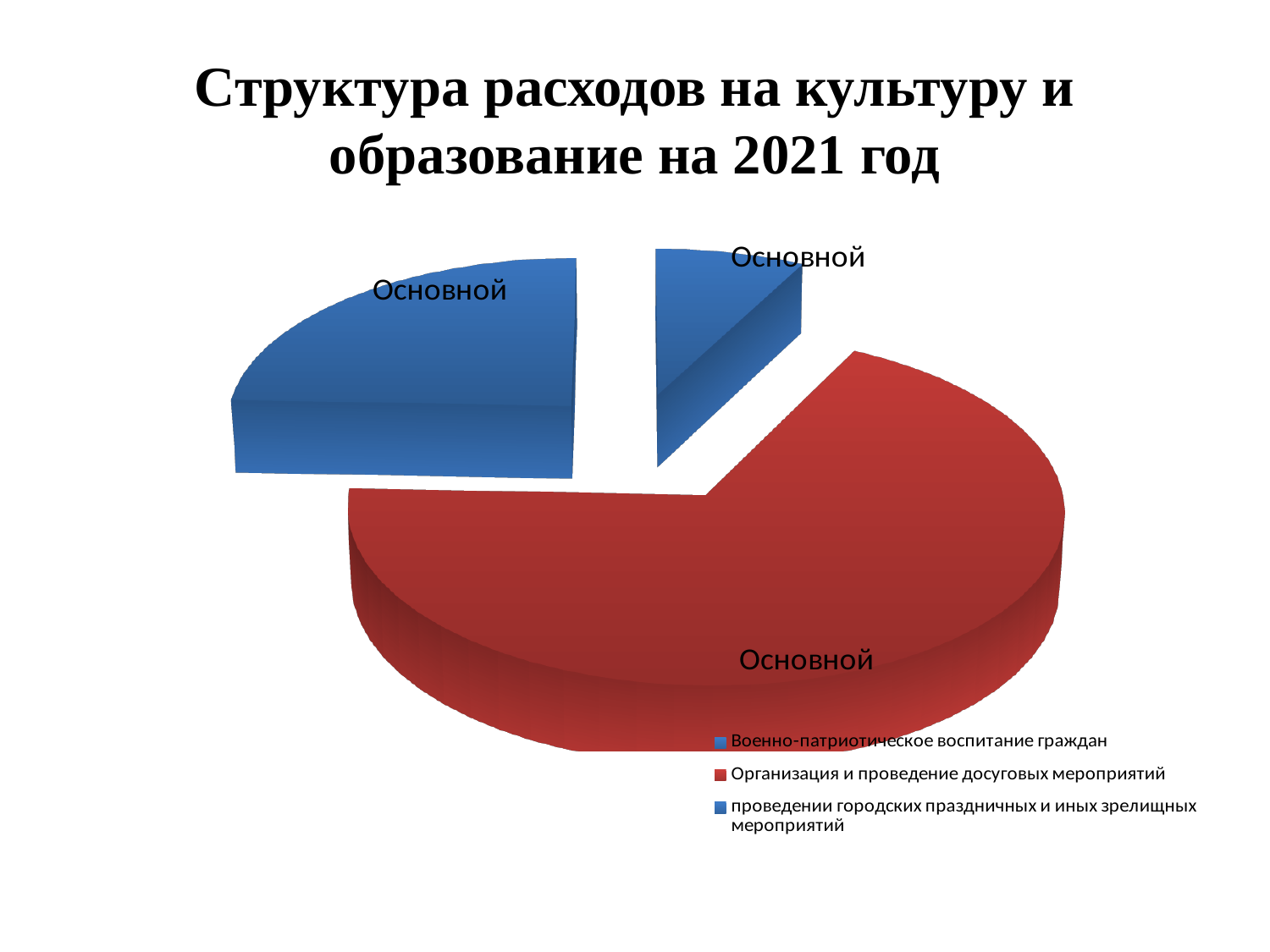
How many entries does the legend of the pie chart list? 3 What kind of chart is shown on the slide? pie chart How many slices does the pie chart have? 3 Which category has the largest slice in the pie chart? Организация и проведение досуговых мероприятий What colour is the largest slice of the pie chart? red Is the share of the pie for Организация и проведение досуговых мероприятий greater or less than 50%? greater What is the title of the slide containing the pie chart? Структура расходов на культуру и образование на 2021 год Which slice is larger: Организация и проведение досуговых мероприятий or Военно-патриотическое воспитание граждан? Организация и проведение досуговых мероприятий